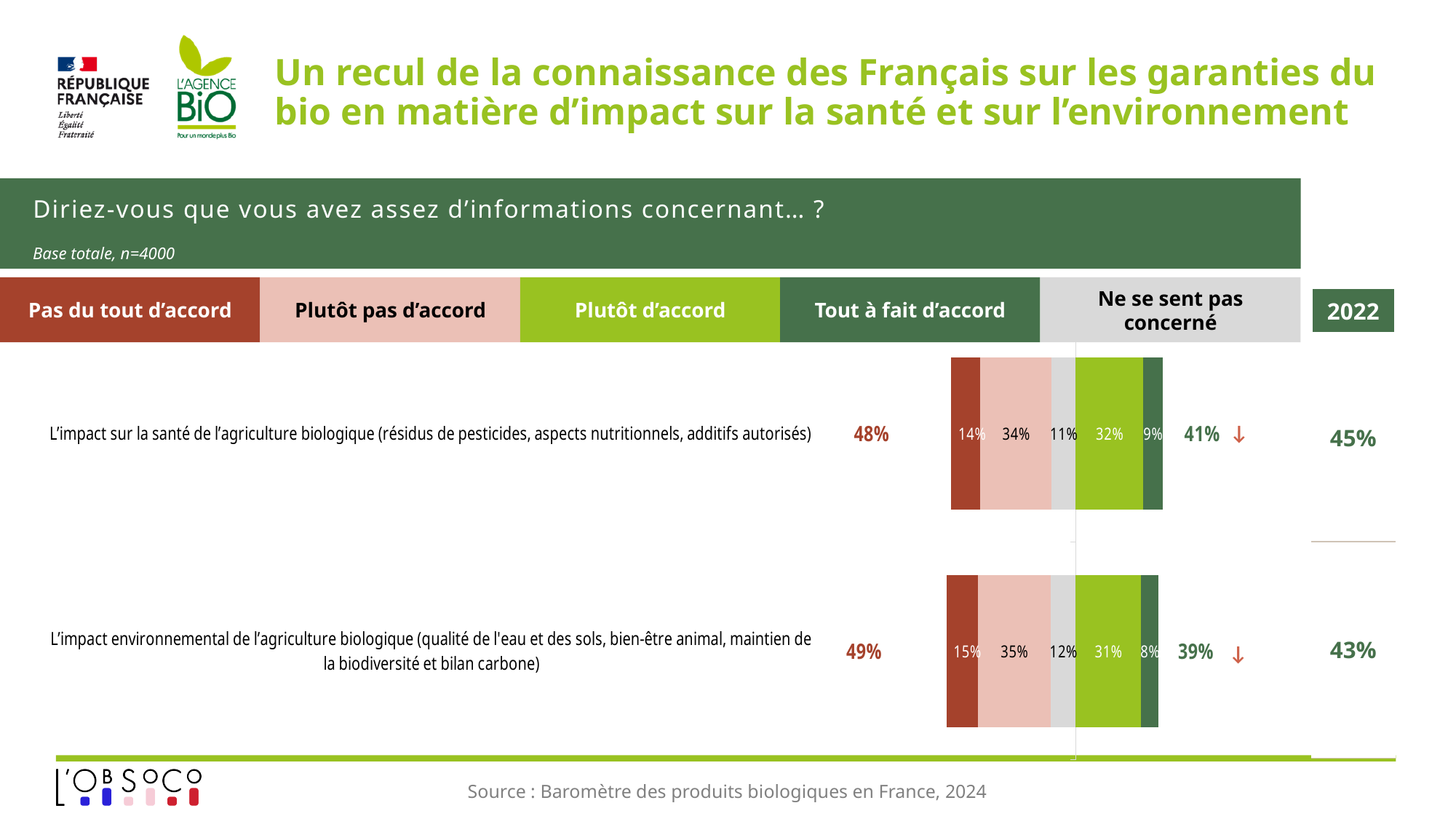
What is the 'Ne se sent pas concerné' value for 'L'impact environnemental de l'agriculture biologique'? 12% How many response categories does the legend list? 5 Which item has the higher 'Plutôt d'accord' value: 'L'impact sur la santé' (32%) or 'L'impact environnemental' (31%)? L'impact sur la santé de l'agriculture biologique What is the base size indicated for the question? n=4000 What is the 'Plutôt pas d'accord' value for 'L'impact environnemental de l'agriculture biologique'? 35% What is the 'Pas du tout d'accord' value for 'L'impact sur la santé de l'agriculture biologique'? 14% What is the combined agreement total (Plutôt d'accord + Tout à fait d'accord) shown for 'L'impact sur la santé de l'agriculture biologique'? 41% What is the 'Tout à fait d'accord' value for 'L'impact sur la santé de l'agriculture biologique'? 9% What was the 2022 value for 'L'impact environnemental de l'agriculture biologique'? 43% What is the difference between the 2022 value (45%) and the current agreement total (41%) for 'L'impact sur la santé de l'agriculture biologique'? 4 points What kind of chart is shown on the slide? stacked bar chart How many items (bars) are plotted in the chart? 2